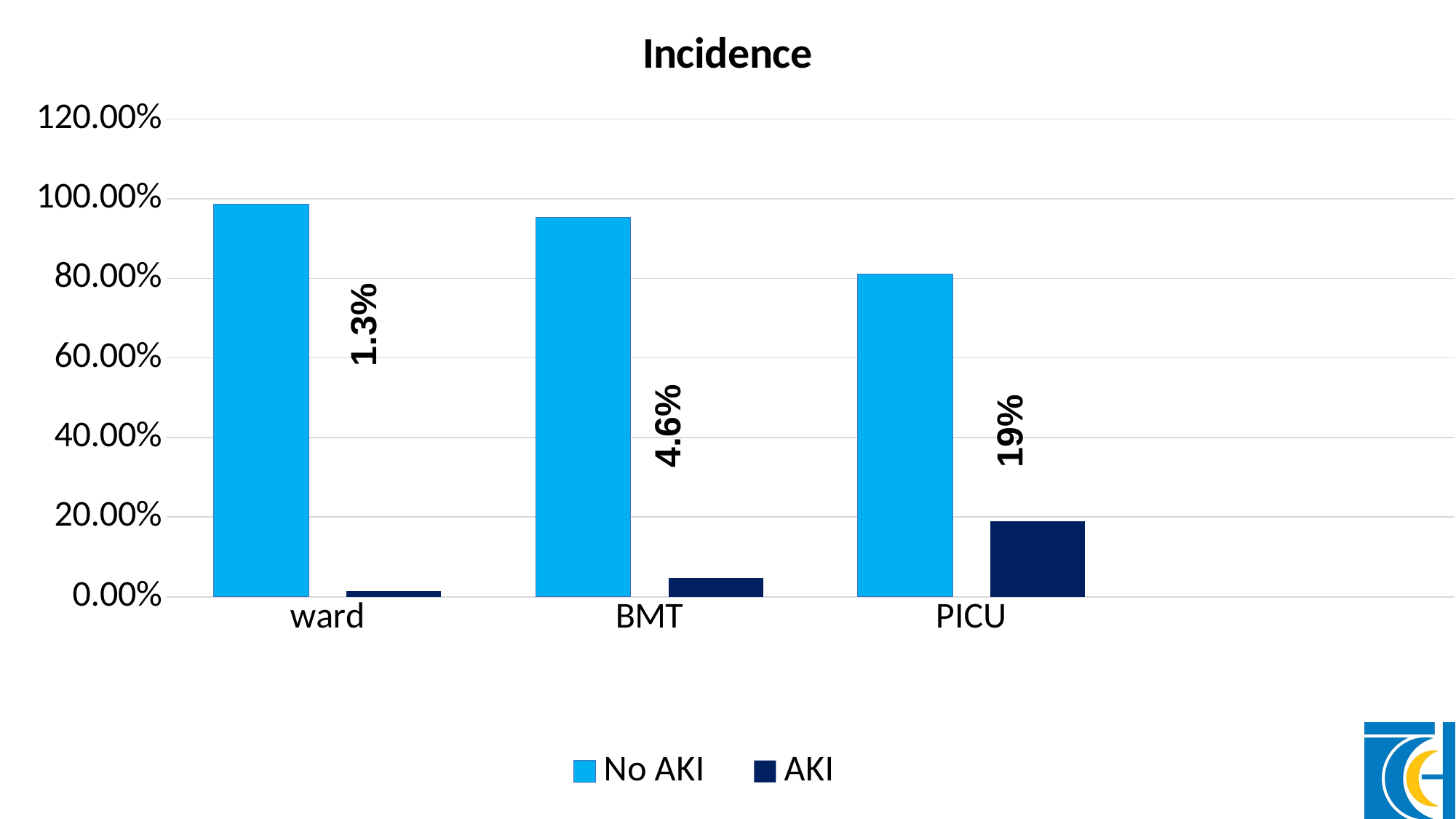
What is the AKI incidence for the ward group? 1.3% Which group has the lowest AKI incidence? ward Does the AKI incidence rise or fall from ward to PICU? rise Is the No AKI value for the PICU group greater or less than 100.00%? less Which group has a higher AKI incidence, BMT or ward? BMT What is the AKI incidence for the PICU group? 19% What kind of chart is shown on the slide? bar chart How many series does the legend list? 2 What is the AKI incidence for the BMT group? 4.6% Is the No AKI value for the ward group greater or less than 80.00%? greater How many groups are shown on the x axis? 3 Which group has the highest AKI incidence? PICU